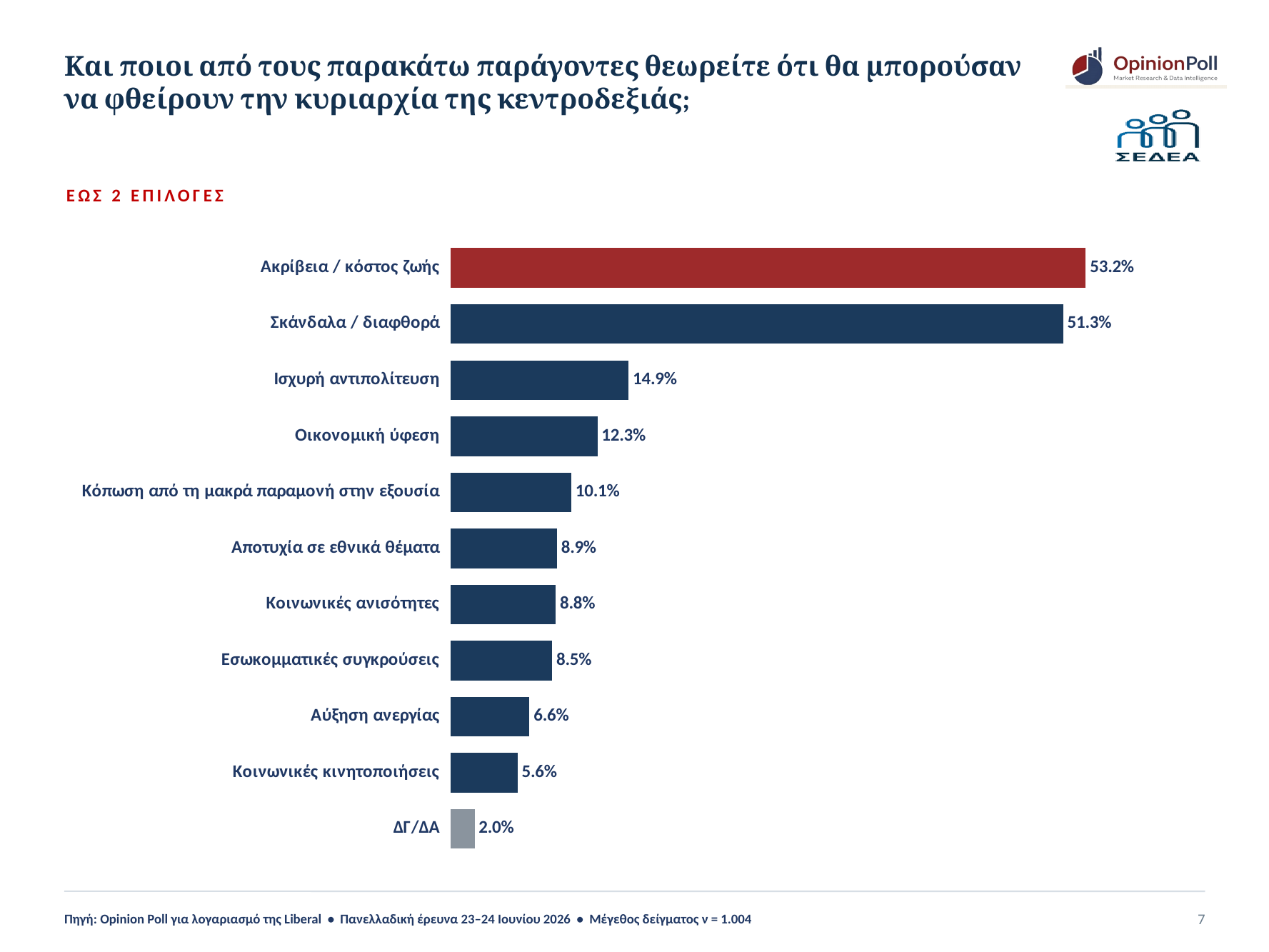
What is the value for Σκάνδαλα / διαφθορά? 51.3% How many categories are shown in the chart? 11 What is the difference between the values for Ισχυρή αντιπολίτευση and Οικονομική ύφεση? 2.6% Which bar is coloured red rather than dark blue? Ακρίβεια / κόστος ζωής What is the value for Κόπωση από τη μακρά παραμονή στην εξουσία? 10.1% What is the value for Ακρίβεια / κόστος ζωής? 53.2% What is the difference between the values for Ακρίβεια / κόστος ζωής and Σκάνδαλα / διαφθορά? 1.9% Which category has the lowest value? ΔΓ/ΔΑ Which is larger, the value for Αύξηση ανεργίας or the value for Εσωκομματικές συγκρούσεις? Εσωκομματικές συγκρούσεις Which category has the highest value? Ακρίβεια / κόστος ζωής What kind of chart is shown on the slide? Bar chart What is the value for Κοινωνικές κινητοποιήσεις? 5.6%